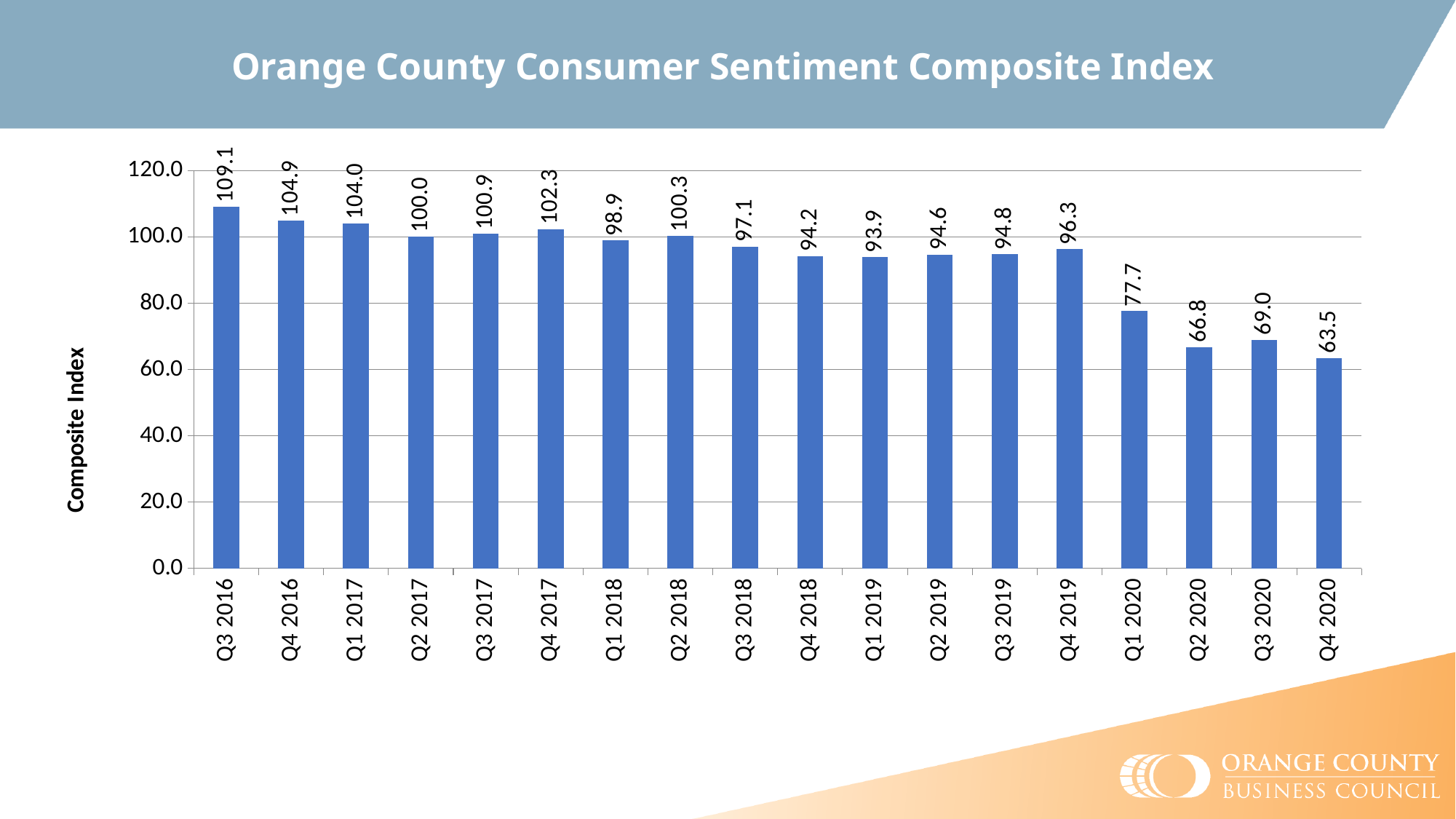
Which quarter has the lowest composite index value? Q4 2020 What is the composite index value for Q3 2016? 109.1 Which is larger, the composite index value for Q2 2020 or Q3 2020? Q3 2020 What is the title of the chart? Orange County Consumer Sentiment Composite Index Is the value for Q2 2020 greater or less than 80.0? less What kind of chart is shown on the slide? bar chart What is the composite index value for Q4 2020? 63.5 Do the composite index values generally rise or fall from Q3 2016 to Q4 2020? fall How many quarters are shown on the chart? 18 What is the difference between the composite index values for Q4 2019 and Q1 2020? 18.6 Which quarter has the highest composite index value? Q3 2016 What is the composite index value for Q1 2020? 77.7